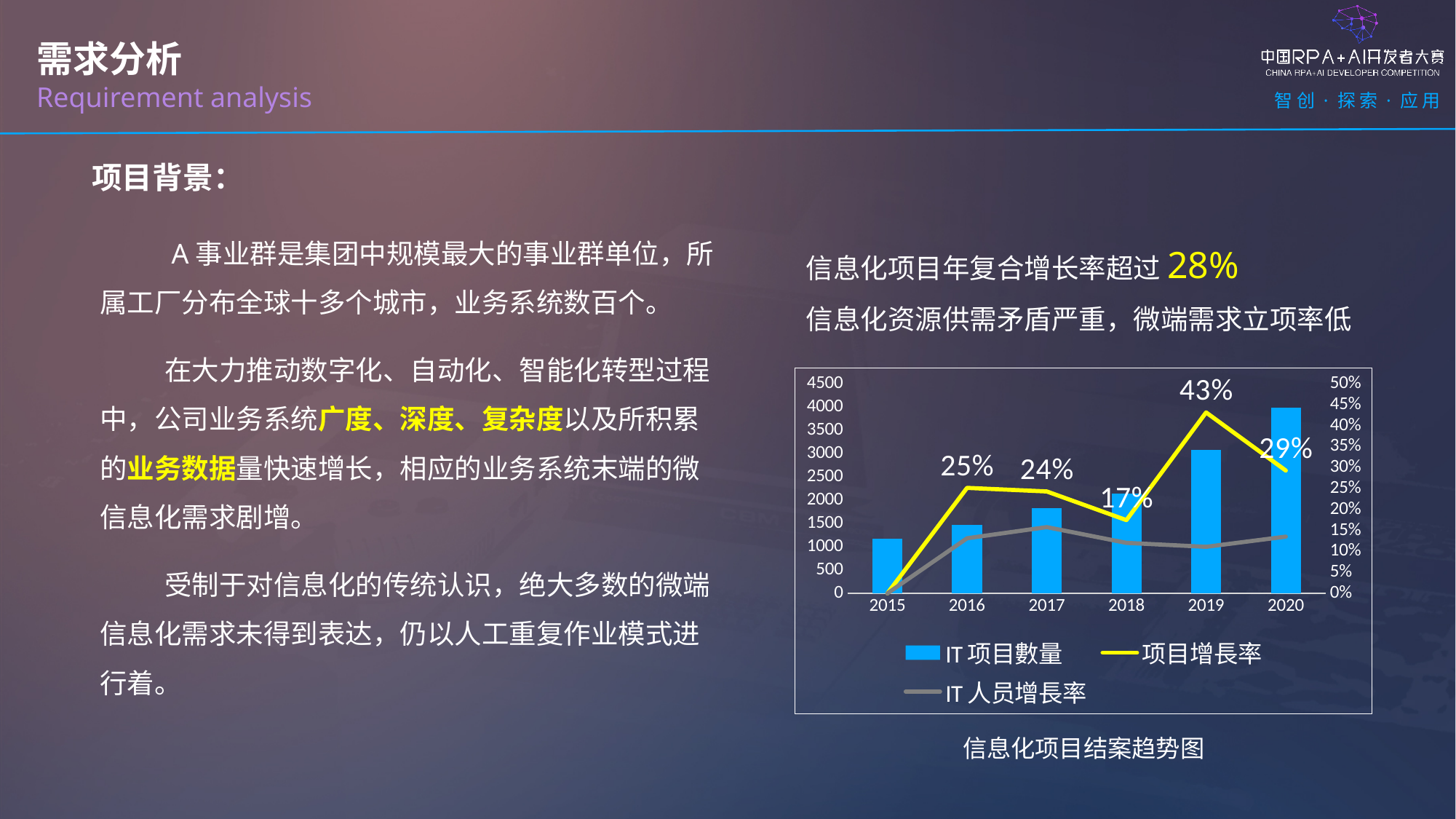
Which year has the highest IT 项目數量? 2020 Is the IT 项目數量 value for 2015 greater or less than 1500? less What is the 项目增长率 value for 2020? 29% How many years are shown on the x axis of the chart? 6 Is the IT 项目數量 value for 2020 greater or less than 3500? greater How many series does the chart legend list? 3 What is the 项目增长率 value for 2019? 43% What is the difference between the 项目增长率 for 2019 and 2020? 14% What kind of chart is shown on the slide? Combination bar and line chart What is the 项目增长率 value for 2016? 25% Which year has the larger 项目增长率, 2016 or 2017? 2016 Which year has the highest 项目增长率? 2019